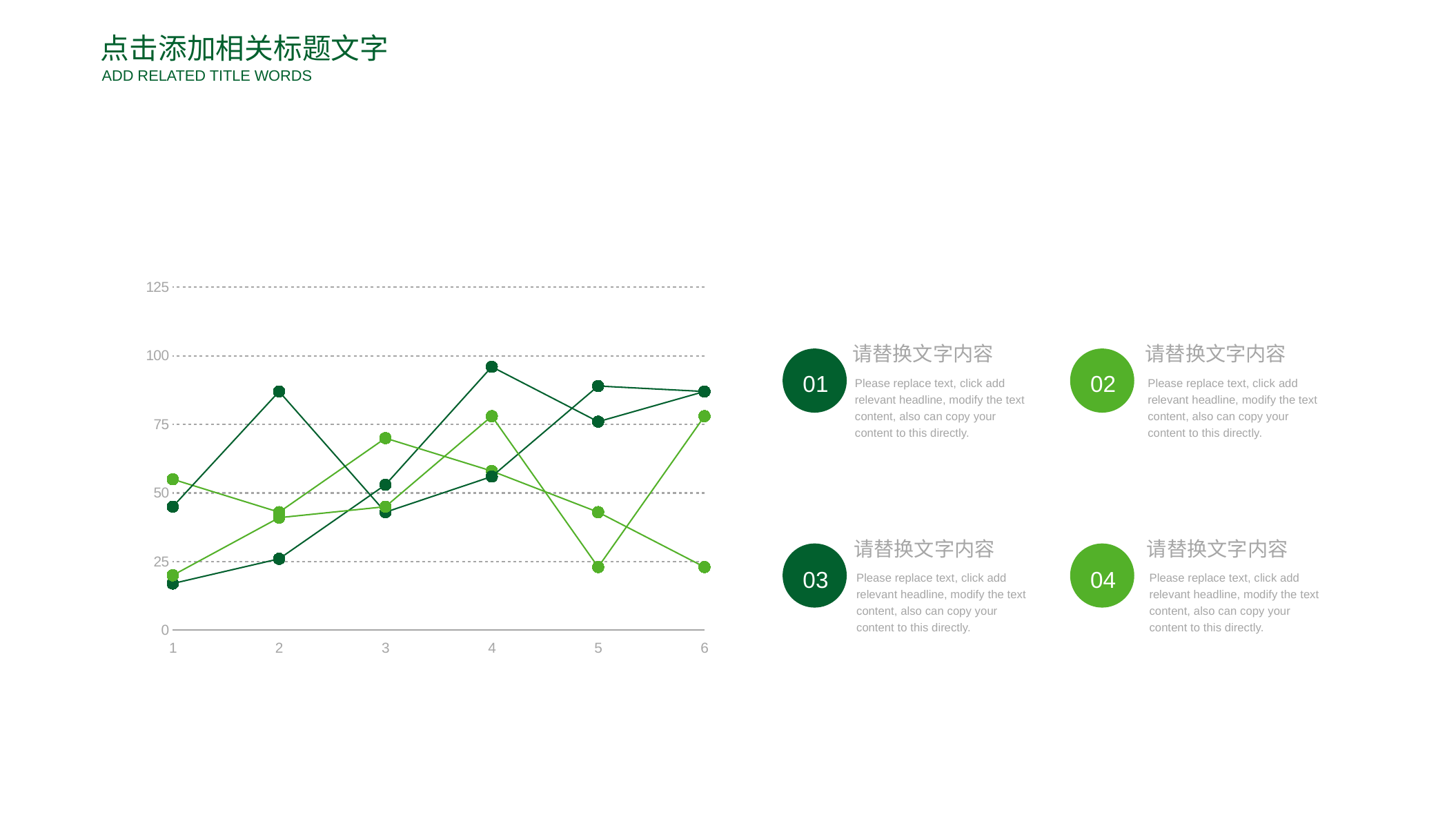
At which x-axis value does the single highest point on the chart occur? 4 Is the highest point plotted at x = 4 greater or less than 75? greater How many points are labelled along the x axis of the chart? 6 What is the highest value shown on the y axis of the chart? 125 Is the lowest point plotted at x = 1 greater or less than 25? less What kind of chart is shown on the slide? line chart Is the highest point plotted at x = 1 greater or less than 75? less What is the first label on the x axis of the chart? 1